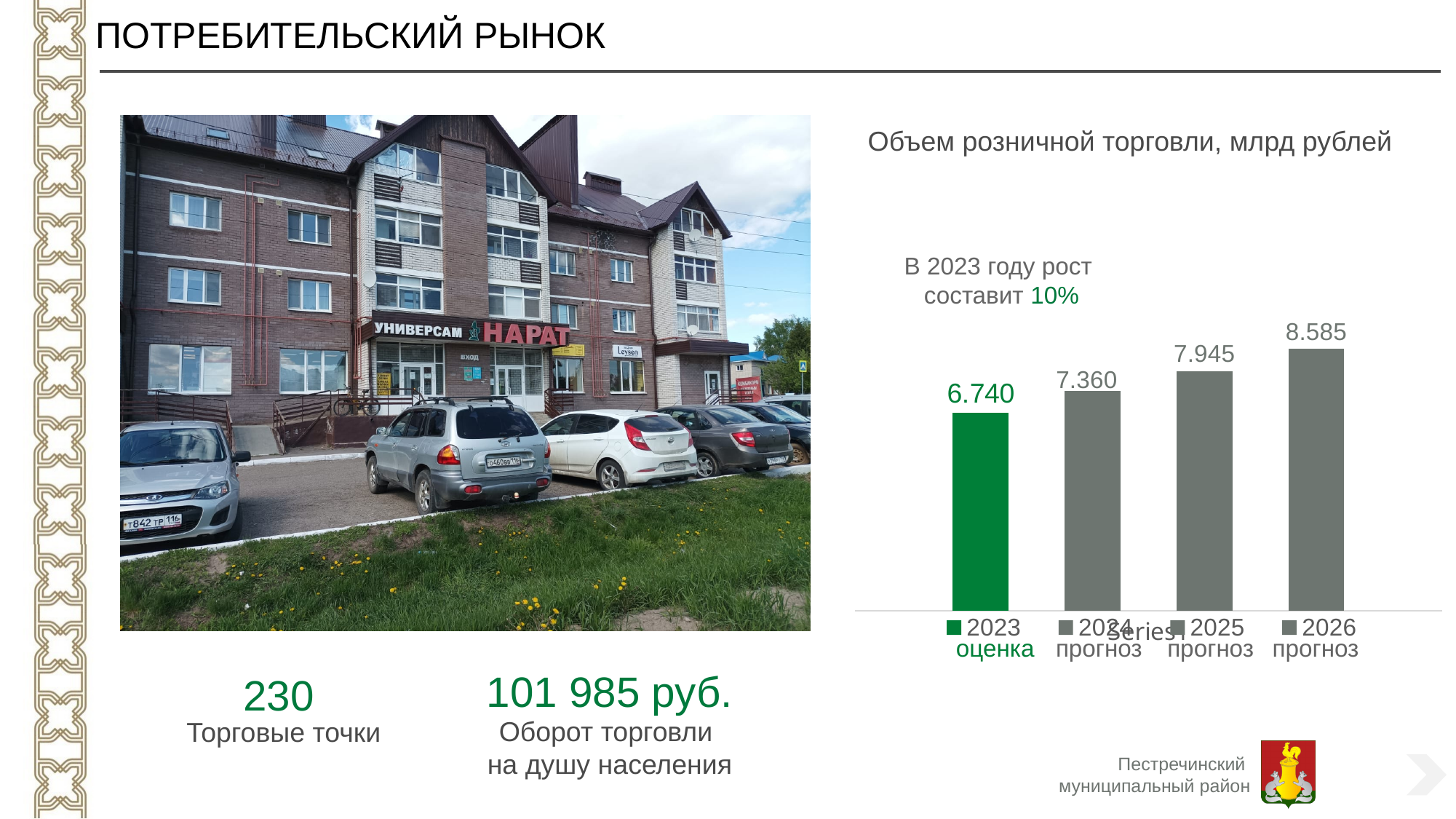
What is the value for 2023 оценка in the chart? 6.740 Do the values in the chart rise or fall from 2023 to 2026? rise What is the value for 2025 прогноз in the chart? 7.945 What is the difference between the values for 2026 прогноз and 2023 оценка? 1.845 What type of chart is shown on the slide? bar chart Which is larger, the value for 2025 прогноз or the value for 2024 прогноз? 2025 прогноз What is the value for 2024 прогноз in the chart? 7.360 Which year has the lowest value in the chart? 2023 оценка What is the title of the chart on the slide? Объем розничной торговли, млрд рублей What is the difference between the values for 2024 прогноз and 2023 оценка? 0.620 Which year has the highest value in the chart? 2026 прогноз What is the value for 2026 прогноз in the chart? 8.585